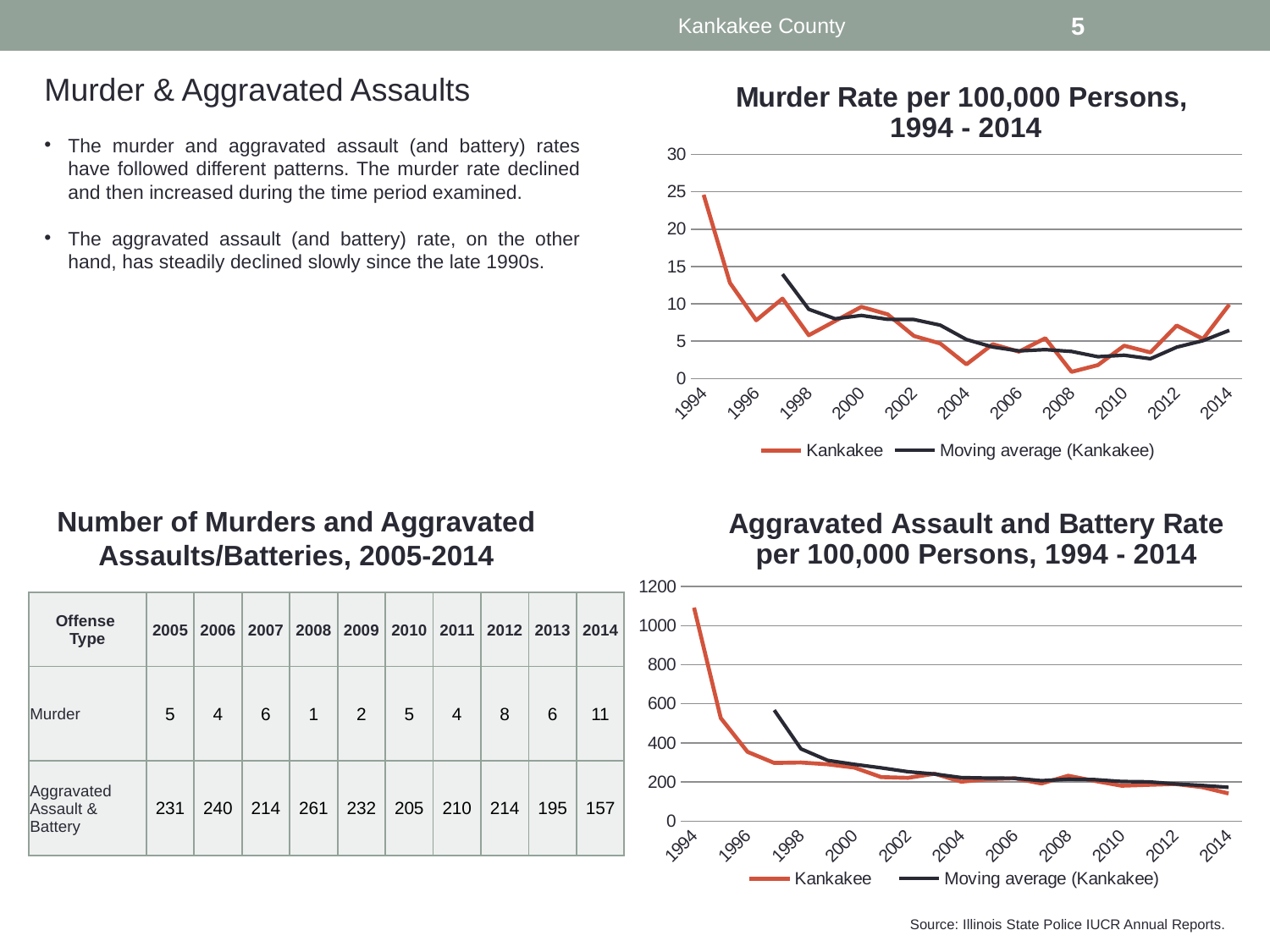
In the 'Aggravated Assault and Battery Rate per 100,000 Persons, 1994 - 2014' chart, is the Kankakee value for 2014 greater or less than 200? less In the 'Murder Rate per 100,000 Persons, 1994 - 2014' chart, is the Kankakee value for 2004 greater or less than 5? less In the 'Murder Rate per 100,000 Persons, 1994 - 2014' chart, which year has the highest Kankakee murder rate? 1994 In the 'Murder Rate per 100,000 Persons, 1994 - 2014' chart, is the Kankakee value for 1994 greater or less than 20? greater What kind of chart is the 'Murder Rate per 100,000 Persons, 1994 - 2014' chart? line chart In the 'Murder Rate per 100,000 Persons, 1994 - 2014' chart, how many series does the legend list? 2 In the 'Murder Rate per 100,000 Persons, 1994 - 2014' chart, which is larger: the Kankakee value for 1994 or for 2014? 1994 What kind of chart is the 'Aggravated Assault and Battery Rate per 100,000 Persons, 1994 - 2014' chart? line chart In the 'Murder Rate per 100,000 Persons, 1994 - 2014' chart, does the Kankakee murder rate rise or fall between 1994 and 2004? fall In the 'Aggravated Assault and Battery Rate per 100,000 Persons, 1994 - 2014' chart, what colour is the Kankakee line? orange In the 'Aggravated Assault and Battery Rate per 100,000 Persons, 1994 - 2014' chart, does the Kankakee rate rise or fall from 1994 to 2014? fall